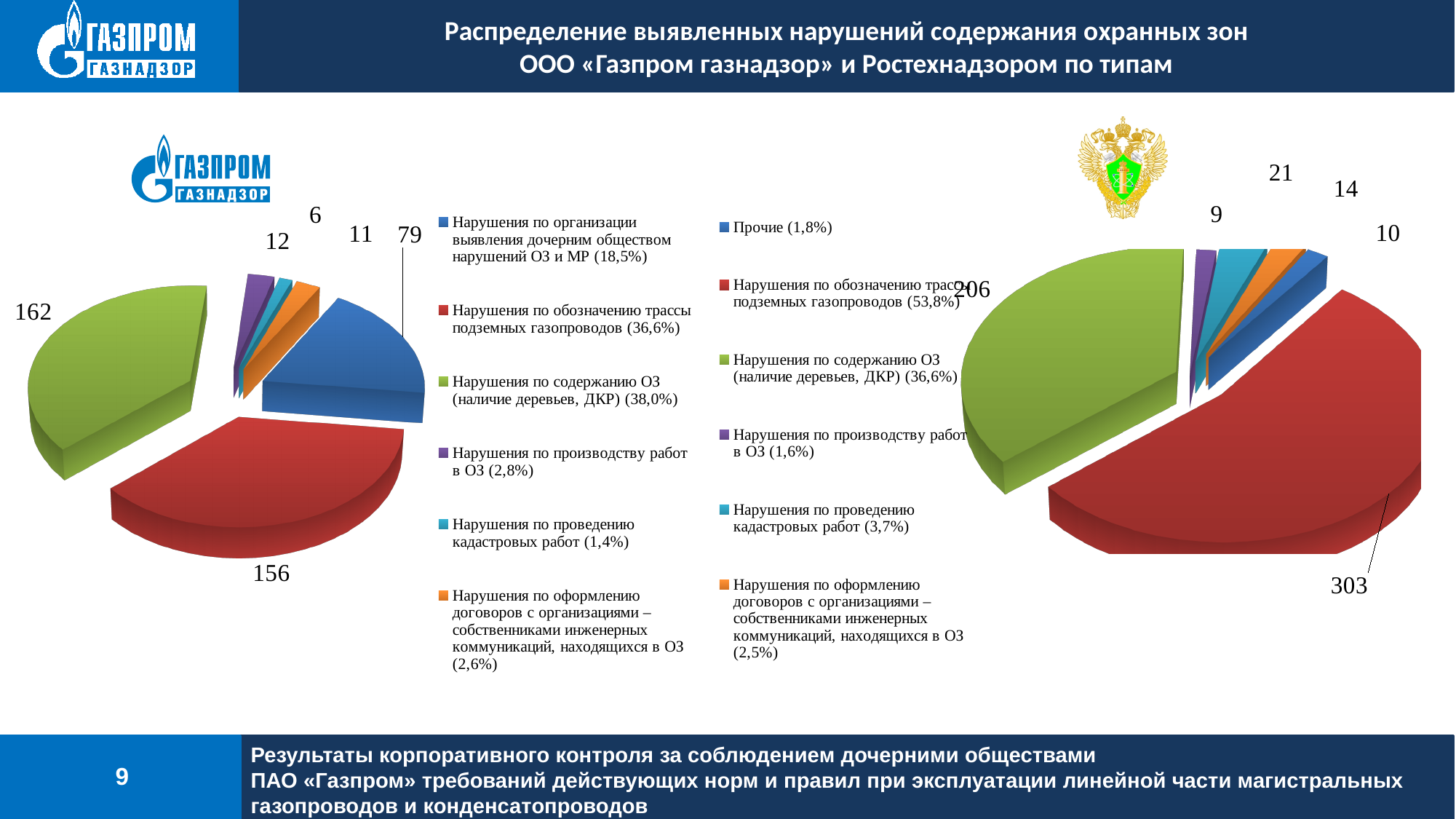
On the right pie chart (Ростехнадзор), what is the difference between the values for «Нарушения по обозначению трассы подземных газопроводов» and «Нарушения по содержанию ОЗ (наличие деревьев, ДКР)»? 97 On the left pie chart (Газпром газнадзор), what share of the pie does «Нарушения по обозначению трассы подземных газопроводов» represent? 36,6% How many categories does the legend of the right pie chart (Ростехнадзор) list? 6 On the left pie chart (Газпром газнадзор), which is larger: «Нарушения по производству работ в ОЗ» or «Нарушения по оформлению договоров с организациями – собственниками инженерных коммуникаций, находящихся в ОЗ»? Нарушения по производству работ в ОЗ On the left pie chart (Газпром газнадзор), what is the value for «Нарушения по организации выявления дочерним обществом нарушений ОЗ и МР»? 79 On the right pie chart (Ростехнадзор), which category has the largest value? Нарушения по обозначению трассы подземных газопроводов On the right pie chart (Ростехнадзор), what is the value for «Нарушения по обозначению трассы подземных газопроводов»? 303 On the left pie chart (Газпром газнадзор), what is the value for «Нарушения по содержанию ОЗ (наличие деревьев, ДКР)»? 162 On the left pie chart (Газпром газнадзор), which category has the smallest value? Нарушения по проведению кадастровых работ On the right pie chart (Ростехнадзор), what share of the pie does «Нарушения по содержанию ОЗ (наличие деревьев, ДКР)» represent? 36,6% What type of chart is used on the left side of the slide (Газпром газнадзор)? Pie chart On the right pie chart (Ростехнадзор), what is the value for «Нарушения по проведению кадастровых работ»? 21